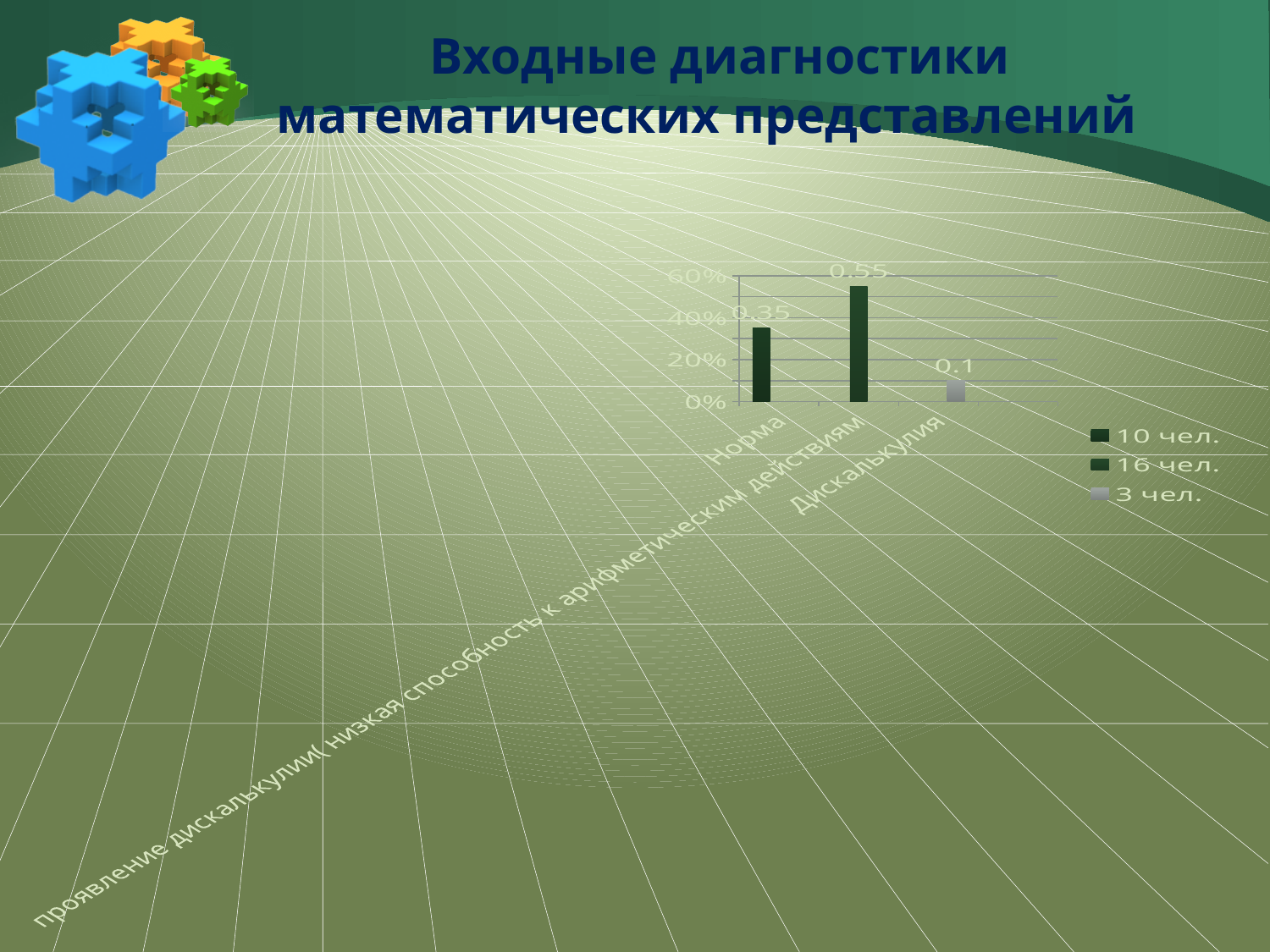
Is the value for "Норма" greater or less than 40%? less Which category has the lowest value? Дискалькулия Which category has the highest value? проявление дискалькулии( низкая способность к арифметическим действиям What legend entry corresponds to the grey bar? 3 чел. How many categories are shown on the x axis of the chart? 3 What is the value shown for the category "проявление дискалькулии( низкая способность к арифметическим действиям"? 0.55 What is the value shown for the category "Дискалькулия"? 0.1 What is the value shown for the category "Норма"? 0.35 What is the difference between the values for "проявление дискалькулии" and "Норма"? 0.2 Which is larger, the value for "Норма" or the value for "Дискалькулия"? Норма What type of chart is shown on the slide? bar chart How many entries does the chart legend list? 3